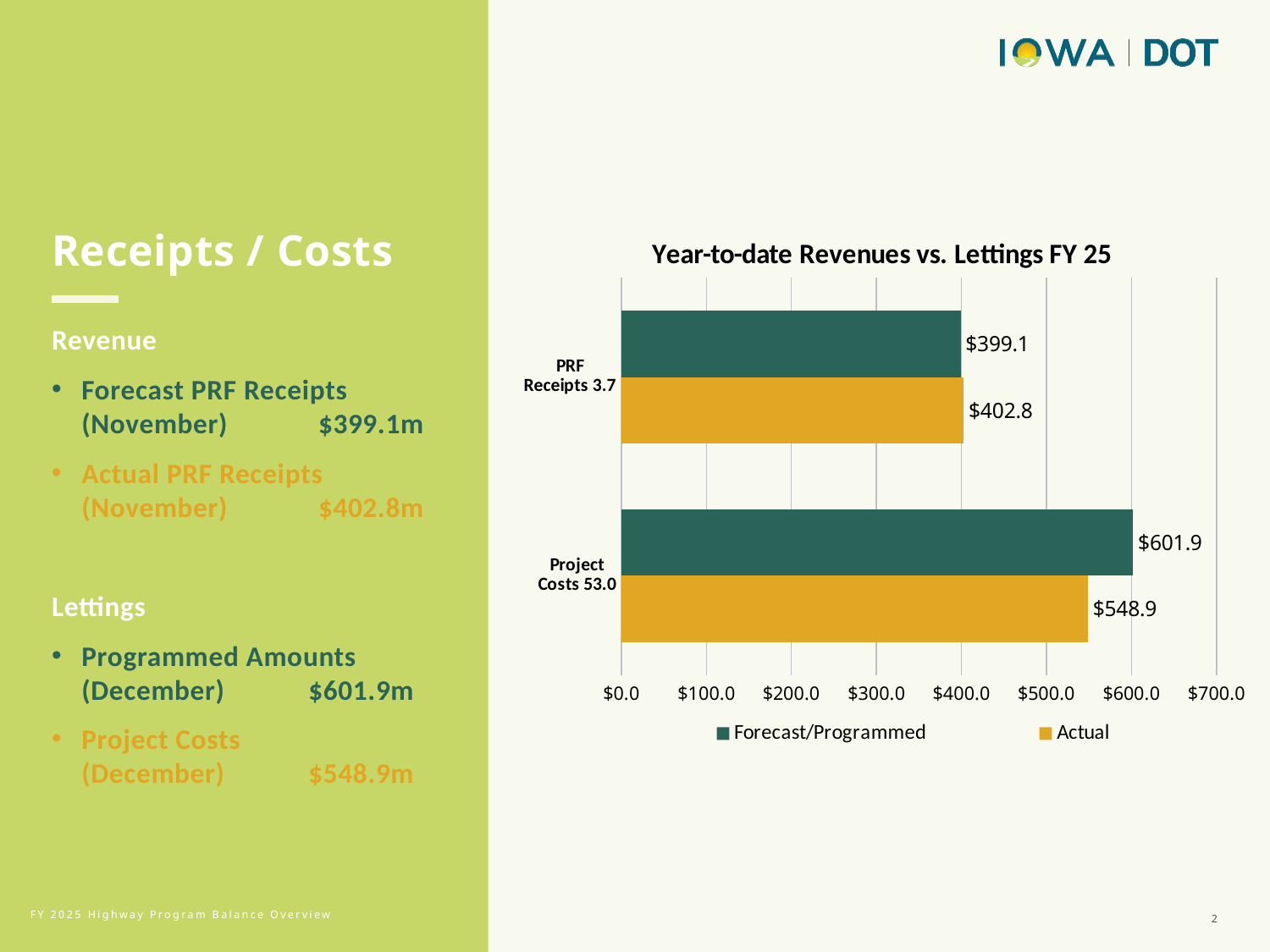
What is the difference between the Forecast/Programmed and Actual values for Project Costs? $53.0 Which bar in the chart has the highest value? Forecast/Programmed for Project Costs What is the Forecast/Programmed value for Project Costs? $601.9 What is the Forecast/Programmed value for PRF Receipts? $399.1 What is the Actual value for Project Costs? $548.9 For PRF Receipts, which is larger: the Forecast/Programmed value or the Actual value? Actual How many categories are shown on the chart's vertical axis? 2 What type of chart is shown on the slide? Bar chart How many series does the chart's legend list? 2 What is the Actual value for PRF Receipts? $402.8 Is the Actual value for Project Costs greater or less than $500.0? greater Which bar in the chart has the lowest value? Forecast/Programmed for PRF Receipts